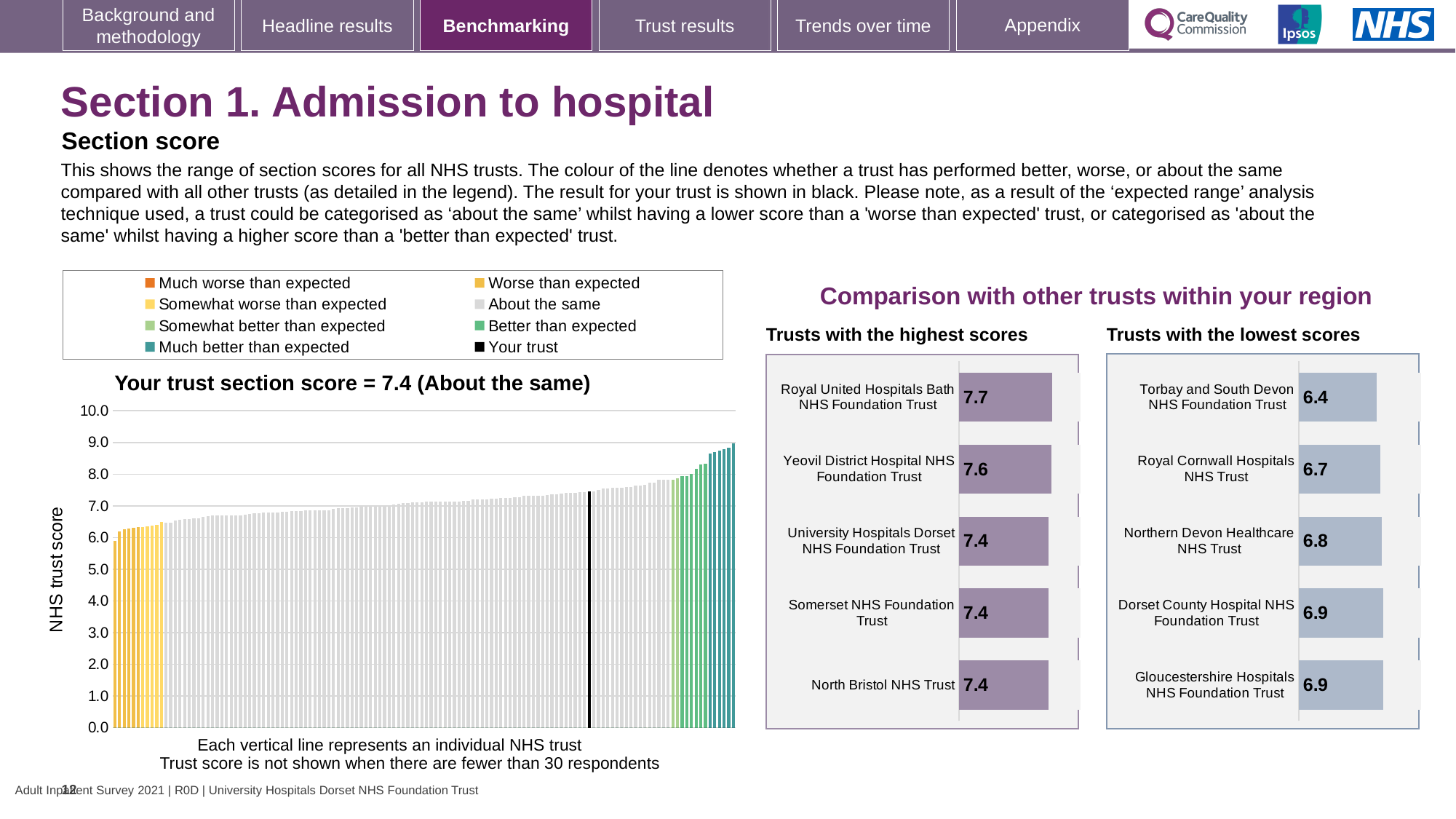
On the 'Trusts with the lowest scores' chart, what is the score for Torbay and South Devon NHS Foundation Trust? 6.4 On the main chart on the left, do the bars rise or fall from left to right along the x axis? rise On the 'Trusts with the highest scores' chart, what is the score for Yeovil District Hospital NHS Foundation Trust? 7.6 On the 'Trusts with the highest scores' chart, which trust has the highest score? Royal United Hospitals Bath NHS Foundation Trust On the 'Trusts with the highest scores' chart, what is the difference between the scores of Royal United Hospitals Bath NHS Foundation Trust and North Bristol NHS Trust? 0.3 On the 'Trusts with the highest scores' chart, what is the score for Royal United Hospitals Bath NHS Foundation Trust? 7.7 How many trusts are listed on the 'Trusts with the lowest scores' chart? 5 On the 'Trusts with the lowest scores' chart, which trust has the lowest score? Torbay and South Devon NHS Foundation Trust On the main chart on the left, what is your trust's section score? 7.4 On the 'Trusts with the lowest scores' chart, which has the larger score: Royal Cornwall Hospitals NHS Trust or Northern Devon Healthcare NHS Trust? Northern Devon Healthcare NHS Trust How many entries does the legend above the main chart on the left list? 8 On the 'Trusts with the lowest scores' chart, what is the difference between the scores of Gloucestershire Hospitals NHS Foundation Trust and Torbay and South Devon NHS Foundation Trust? 0.5